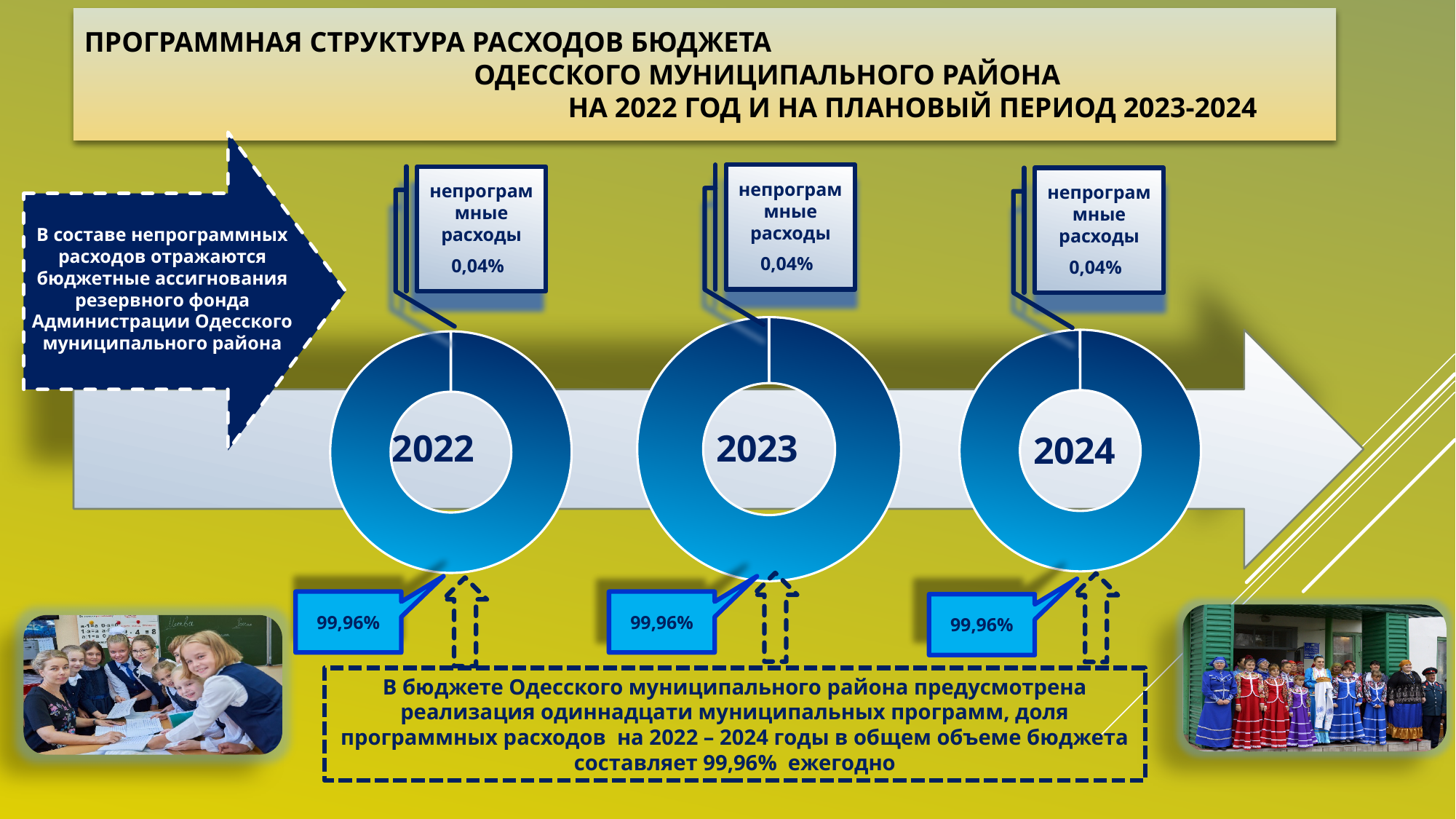
Does the share of непрограммные расходы change between the 2022, 2023 and 2024 charts? No, it stays at 0,04% In the 2024 chart, what share is labelled for непрограммные расходы? 0,04% In the 2022 chart, what share is labelled for непрограммные расходы? 0,04% How many donut charts are shown on the slide? 3 In the 2024 chart, what is the total of the two labelled shares (99,96% and 0,04%)? 100% Which years are labelled in the centres of the three donut charts? 2022, 2023, 2024 In the 2023 chart, what share is labelled for непрограммные расходы? 0,04% In the 2022 chart, what is the difference between the 99,96% share and the 0,04% share? 99,92% What kind of chart is used for each year on the slide? Pie (donut) chart In the 2024 chart, what share is shown in the blue callout below the donut (programme expenses)? 99,96% In the 2022 chart, what share is shown in the blue callout below the donut (programme expenses)? 99,96% In the 2023 chart, which slice is larger: the 99,96% slice or the непрограммные расходы slice? The 99,96% slice